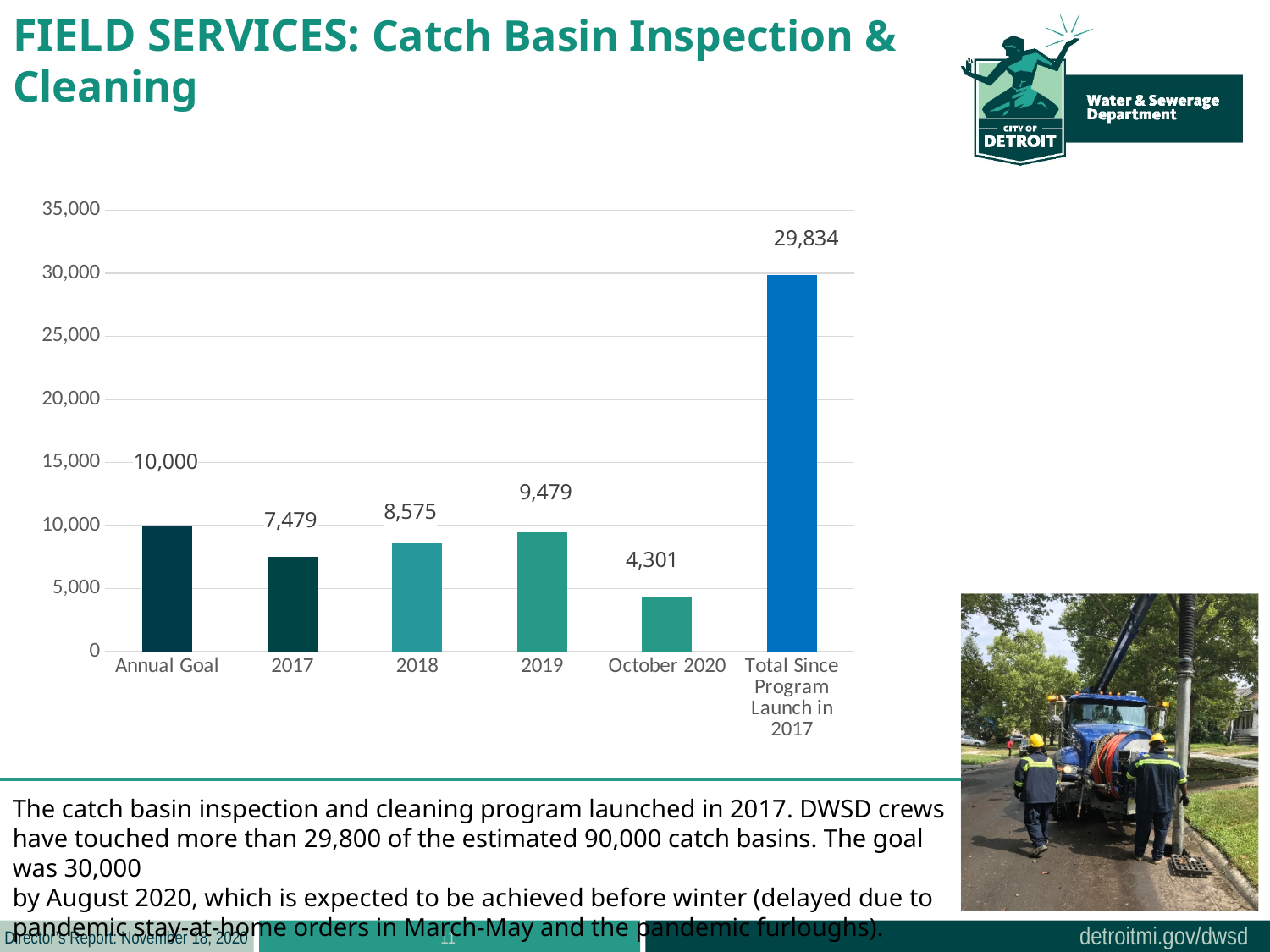
What is the value for October 2020? 4,301 Which category has the highest value? Total Since Program Launch in 2017 What is the value for 2018? 8,575 Which category has the lowest value? October 2020 How many bars are shown in the chart? 6 Is the value for 2017 greater or less than 10,000? less What is the difference between the values for 2019 and 2017? 2,000 Which is larger, the value for 2018 or the value for 2019? 2019 Do the values rise or fall from 2017 to 2019? rise What kind of chart is shown on the slide? bar chart What is the value for Total Since Program Launch in 2017? 29,834 What is the value for Annual Goal? 10,000